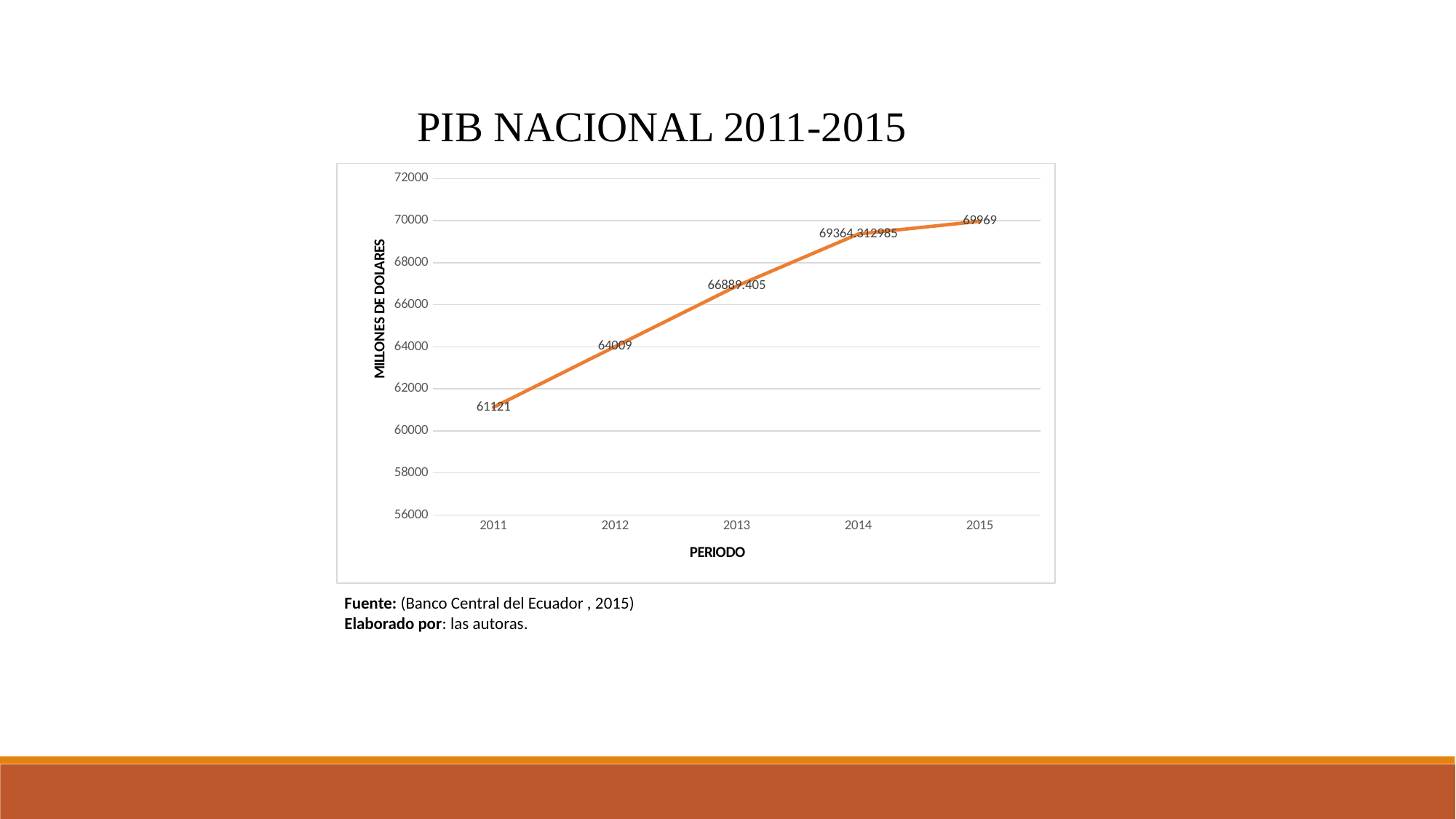
What kind of chart is shown on the slide? Line chart What is the PIB value for 2015? 69969 What is the PIB value for 2012? 64009 What is the PIB value for 2011? 61121 What is the PIB value for 2014? 69364.312985 Which is larger, the PIB value for 2013 or for 2014? 2014 Which year has the highest PIB value? 2015 What is the difference between the PIB values for 2015 and 2011? 8848 What is the PIB value for 2013? 66889.405 How many years are plotted on the chart? 5 Which year has the lowest PIB value? 2011 What is the difference between the PIB values for 2012 and 2011? 2888